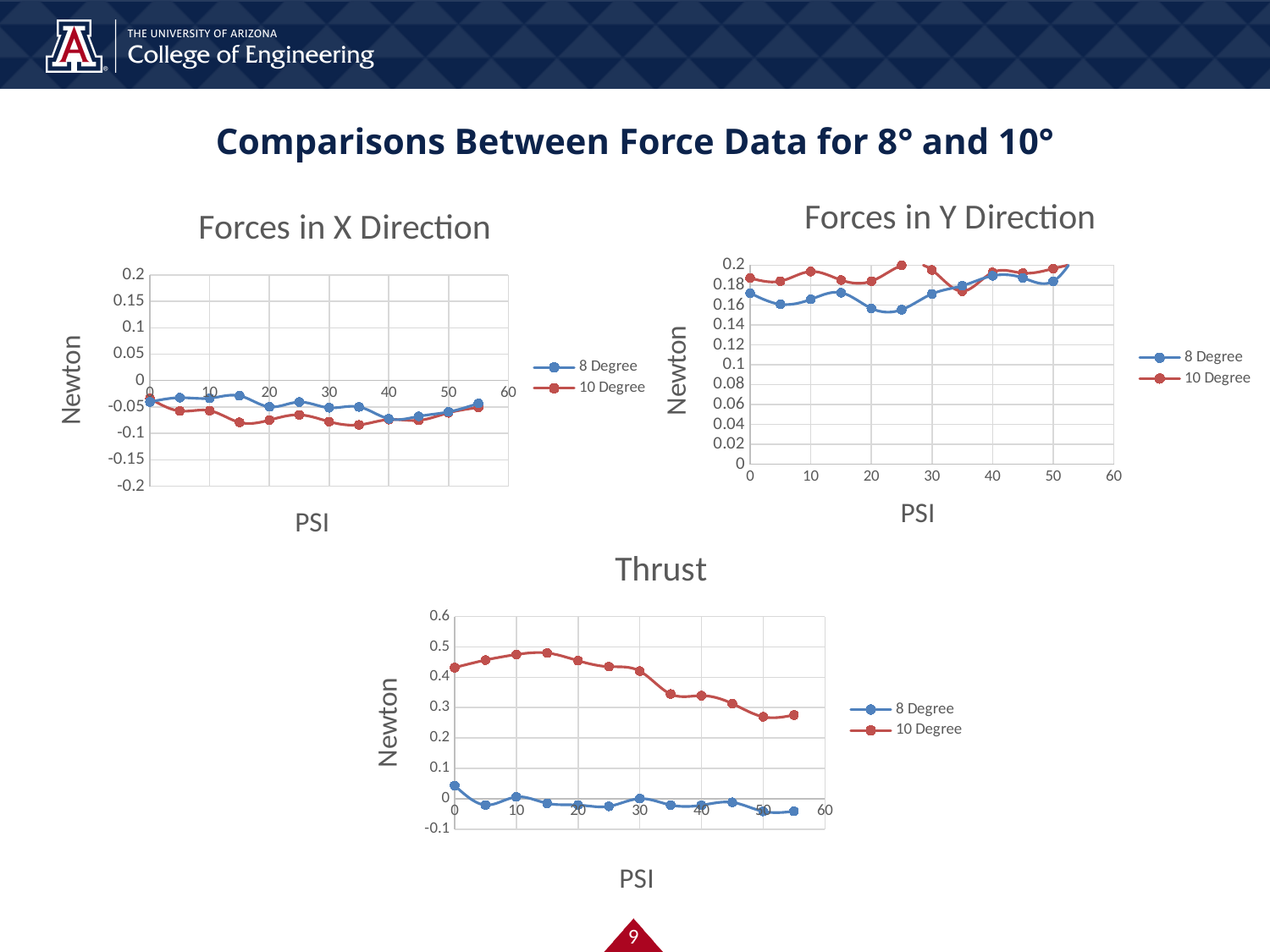
In the "Forces in X Direction" chart, which series has the larger value at 15 PSI, 8 Degree or 10 Degree? 8 Degree In the "Forces in Y Direction" chart, is the 8 Degree value at 25 PSI greater or less than 0.18? less What are the two series named in the legend of the "Forces in Y Direction" chart? 8 Degree and 10 Degree How many series does the legend of the "Forces in X Direction" chart list? 2 In the "Thrust" chart, does the 10 Degree series overall rise or fall from 0 PSI to 55 PSI? fall In the "Forces in X Direction" chart, is the 10 Degree value at 15 PSI greater or less than -0.05? less What is the y-axis label on the "Thrust" chart? Newton What kind of chart is the "Thrust" chart? line chart How many data points does the 10 Degree series have in the "Thrust" chart? 12 In the "Thrust" chart, is the 10 Degree value at 50 PSI greater or less than 0.3? less In the "Thrust" chart, which series is higher at 20 PSI, 8 Degree or 10 Degree? 10 Degree